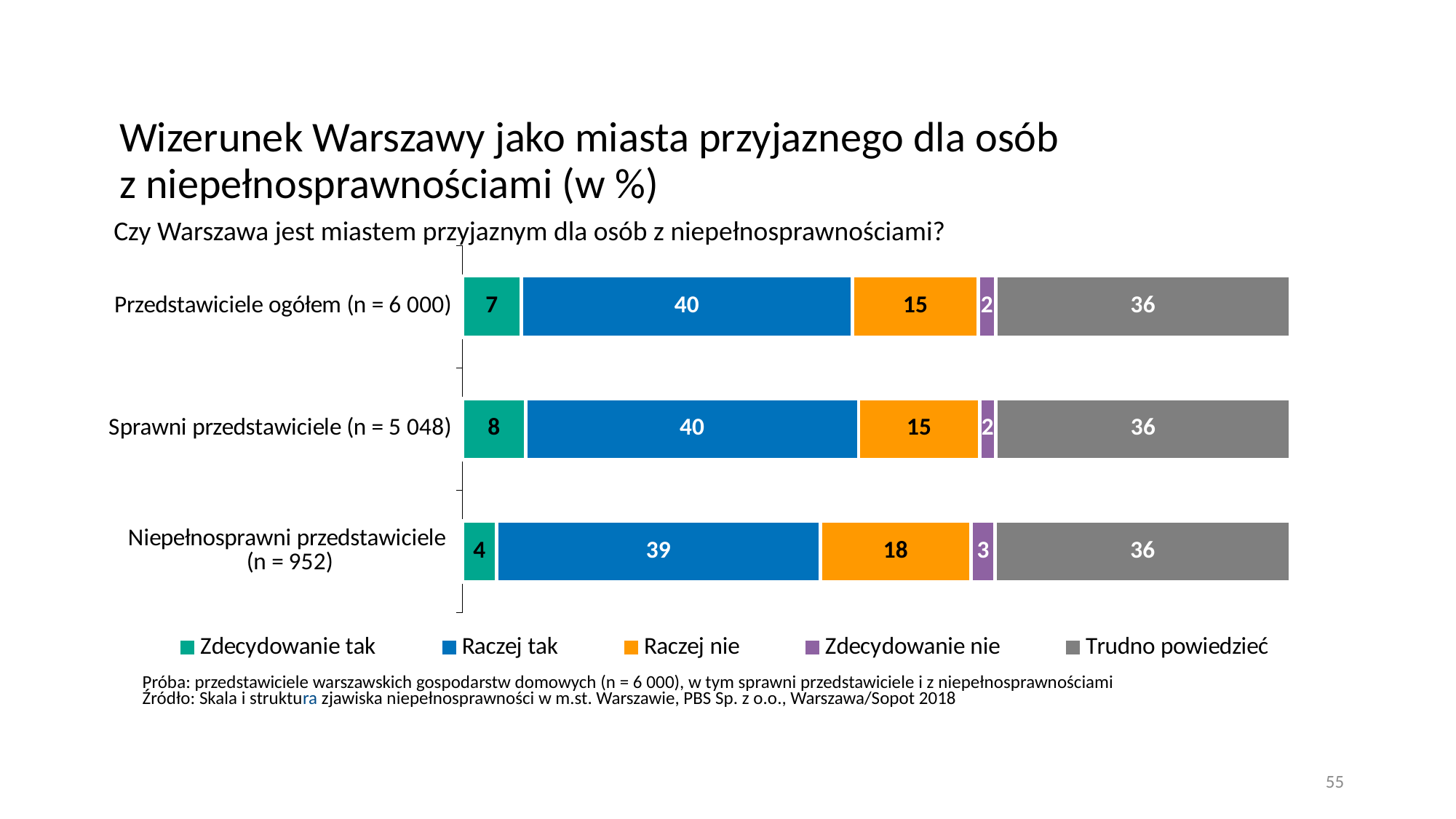
Which category has the lowest value for "Zdecydowanie tak"? Niepełnosprawni przedstawiciele (n = 952) Which category has the highest value for "Raczej nie"? Niepełnosprawni przedstawiciele (n = 952) How many categories (groups of respondents) are shown on the chart? 3 What is the value of "Raczej tak" for "Przedstawiciele ogółem (n = 6 000)"? 40 Which is larger: "Zdecydowanie tak" for "Sprawni przedstawiciele (n = 5 048)" or for "Niepełnosprawni przedstawiciele (n = 952)"? Sprawni przedstawiciele (n = 5 048) What is the value of "Zdecydowanie nie" for "Niepełnosprawni przedstawiciele (n = 952)"? 3 What is the value of "Raczej nie" for "Sprawni przedstawiciele (n = 5 048)"? 15 What kind of chart is shown on the slide? Stacked bar chart What is the total of the stacked bar for "Przedstawiciele ogółem (n = 6 000)"? 100 What is the difference between the "Raczej nie" values for "Niepełnosprawni przedstawiciele (n = 952)" and "Przedstawiciele ogółem (n = 6 000)"? 3 What is the value of "Zdecydowanie tak" for "Niepełnosprawni przedstawiciele (n = 952)"? 4 How many series does the legend list? 5